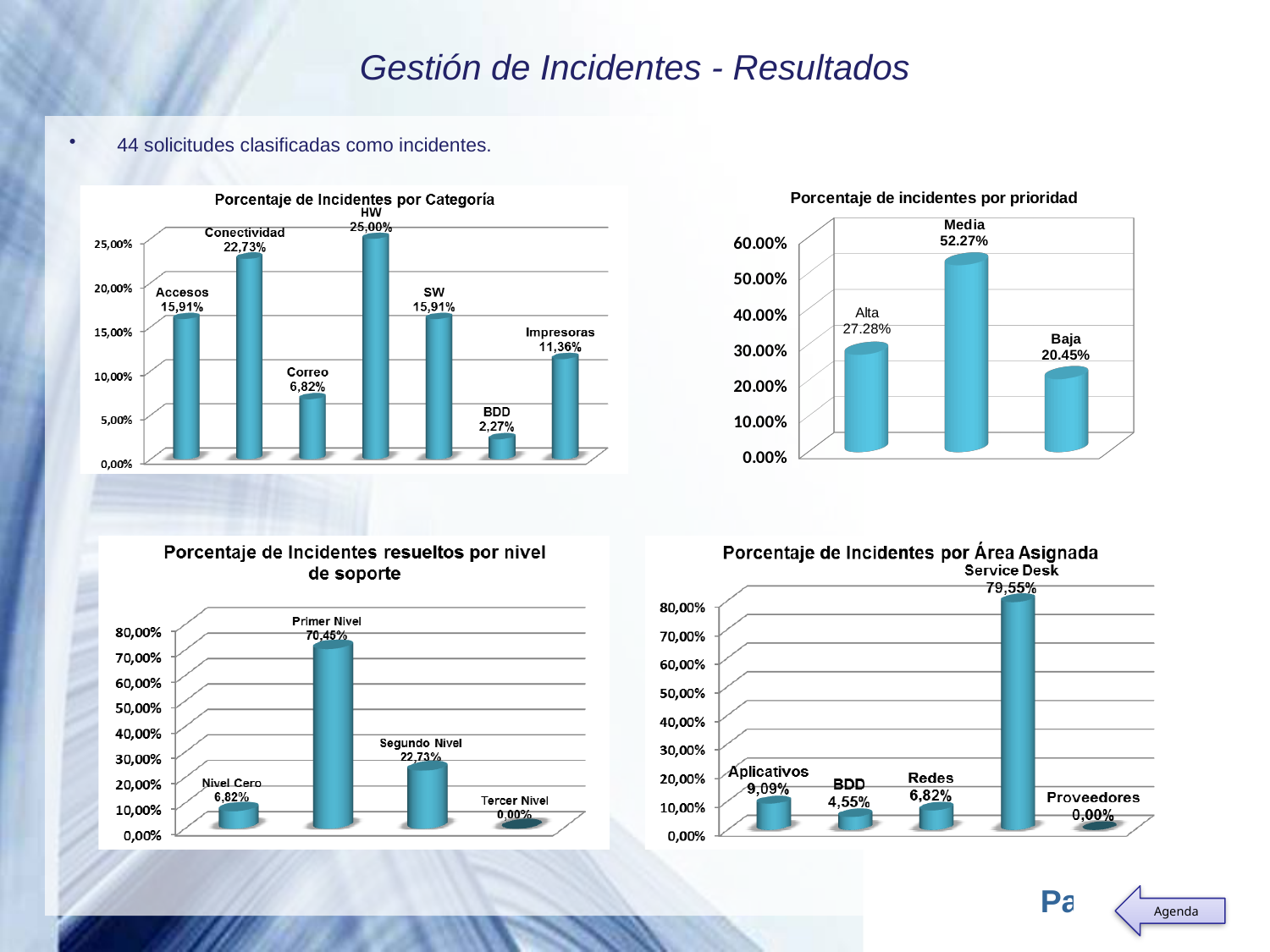
In the chart 'Porcentaje de incidentes por prioridad', what is the value for Alta? 27.28% In the chart 'Porcentaje de Incidentes por Categoría', which category has the lowest value? BDD In the chart 'Porcentaje de Incidentes por Categoría', what is the value for Conectividad? 22,73% In the chart 'Porcentaje de Incidentes resueltos por nivel de soporte', which is larger, Nivel Cero or Segundo Nivel? Segundo Nivel In the chart 'Porcentaje de Incidentes por Categoría', how many categories are shown? 7 In the chart 'Porcentaje de Incidentes por Área Asignada', what is the difference between Aplicativos and BDD? 4,54% What kind of chart is 'Porcentaje de Incidentes por Área Asignada'? Bar chart In the chart 'Porcentaje de incidentes por prioridad', is the value for Media greater or less than 50.00%? greater In the chart 'Porcentaje de Incidentes por Categoría', which category has the highest value? HW In the chart 'Porcentaje de Incidentes resueltos por nivel de soporte', what is the value for Segundo Nivel? 22,73% In the chart 'Porcentaje de incidentes por prioridad', what is the difference between Media and Baja? 31.82% In the chart 'Porcentaje de Incidentes por Área Asignada', what is the value for Service Desk? 79,55%